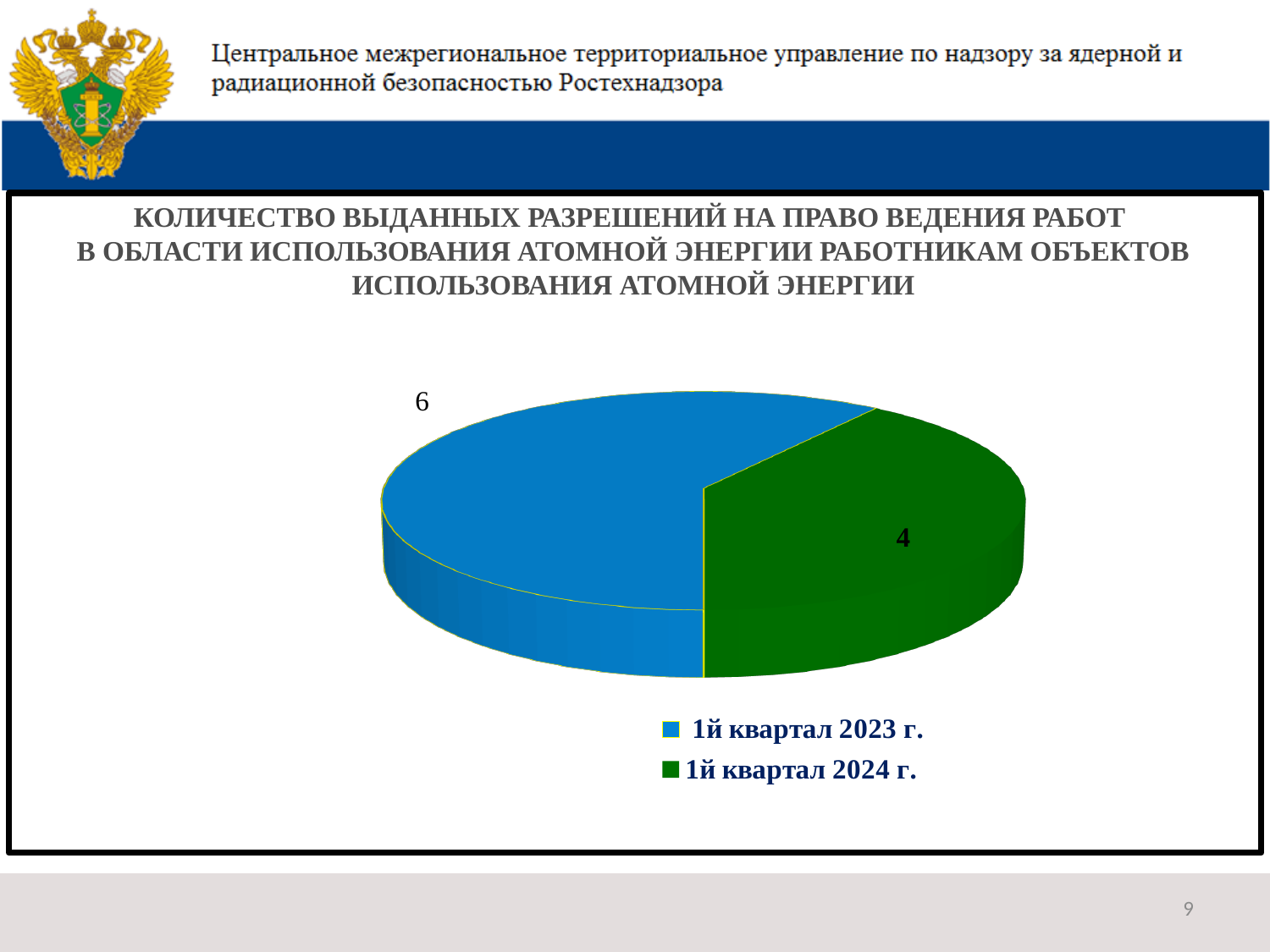
Which category has the smallest slice? 1й квартал 2024 г. How many slices does the pie chart have? 2 What colour is the slice for 1й квартал 2024 г.? green Which category has the largest slice? 1й квартал 2023 г. What is the value for 1й квартал 2024 г.? 4 Which is larger: the value for 1й квартал 2023 г. or 1й квартал 2024 г.? 1й квартал 2023 г. What is the value for 1й квартал 2023 г.? 6 What is the difference between the values for 1й квартал 2023 г. and 1й квартал 2024 г.? 2 How many entries does the legend list? 2 What is the total of the two slices? 10 What type of chart is shown on the slide? pie chart What share of the pie does 1й квартал 2024 г. represent? 40%